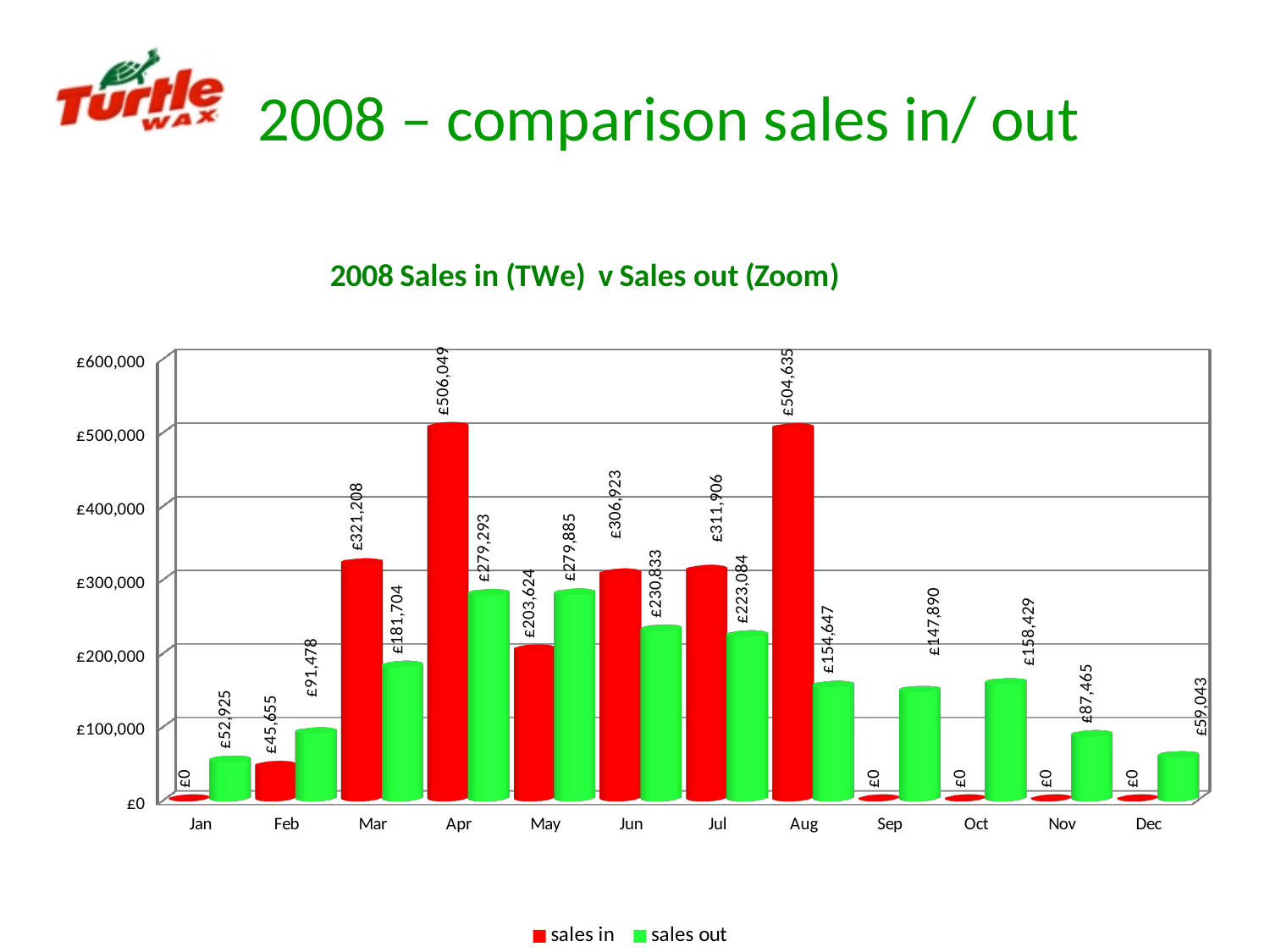
What kind of chart is shown? bar chart What is the sales in value for April? £506,049 What is the sales in value for February? £45,655 What is the sales out value for October? £158,429 In June, which is larger: sales in or sales out? sales in Do the sales out values rise or fall from January to April? rise In February, which is larger: sales in or sales out? sales out What is the difference between sales in and sales out in March? £139,504 How many months are shown on the x axis? 12 Which month has the highest sales in value? Apr Which month has the lowest sales out value? Jan How many series does the legend list? 2